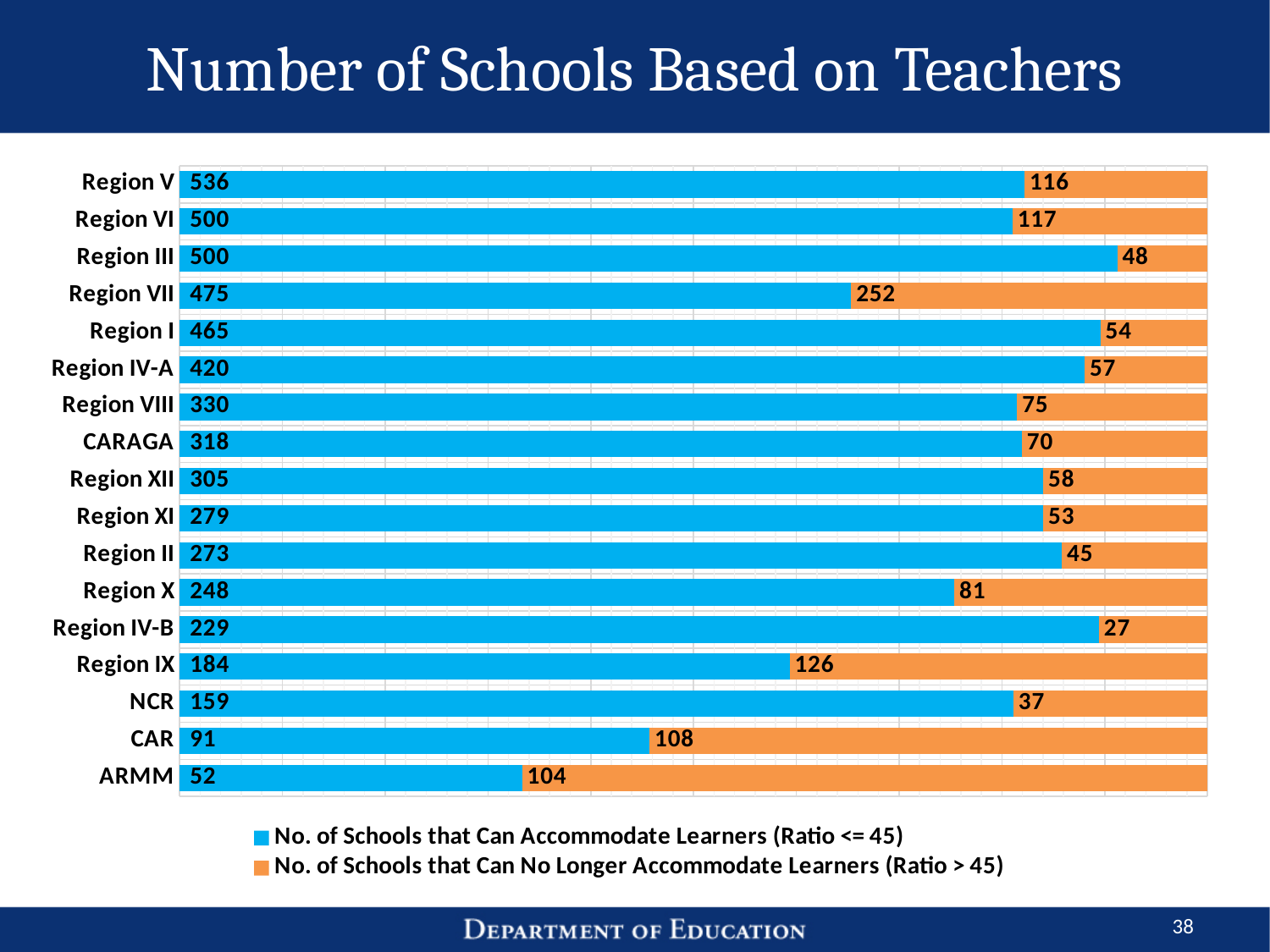
Which region has the highest number of schools that can no longer accommodate learners (Ratio > 45)? Region VII What is the number of schools that can no longer accommodate learners (Ratio > 45) in Region IX? 126 What is the number of schools that can accommodate learners (Ratio <= 45) in Region VII? 475 Which region has the lowest number of schools that can no longer accommodate learners (Ratio > 45)? Region IV-B Which region has the highest number of schools that can accommodate learners (Ratio <= 45)? Region V In CAR, which is larger: the number of schools that can accommodate learners or the number that can no longer accommodate learners? No. of Schools that Can No Longer Accommodate Learners (Ratio > 45) Which region has the lowest number of schools that can accommodate learners (Ratio <= 45)? ARMM What type of chart is shown on the slide? Stacked bar chart How many regions are shown in the chart? 17 What is the total number of schools shown for Region V? 652 What is the difference between the number of schools that can no longer accommodate learners in Region VII and in Region IX? 126 How many series does the legend list? 2